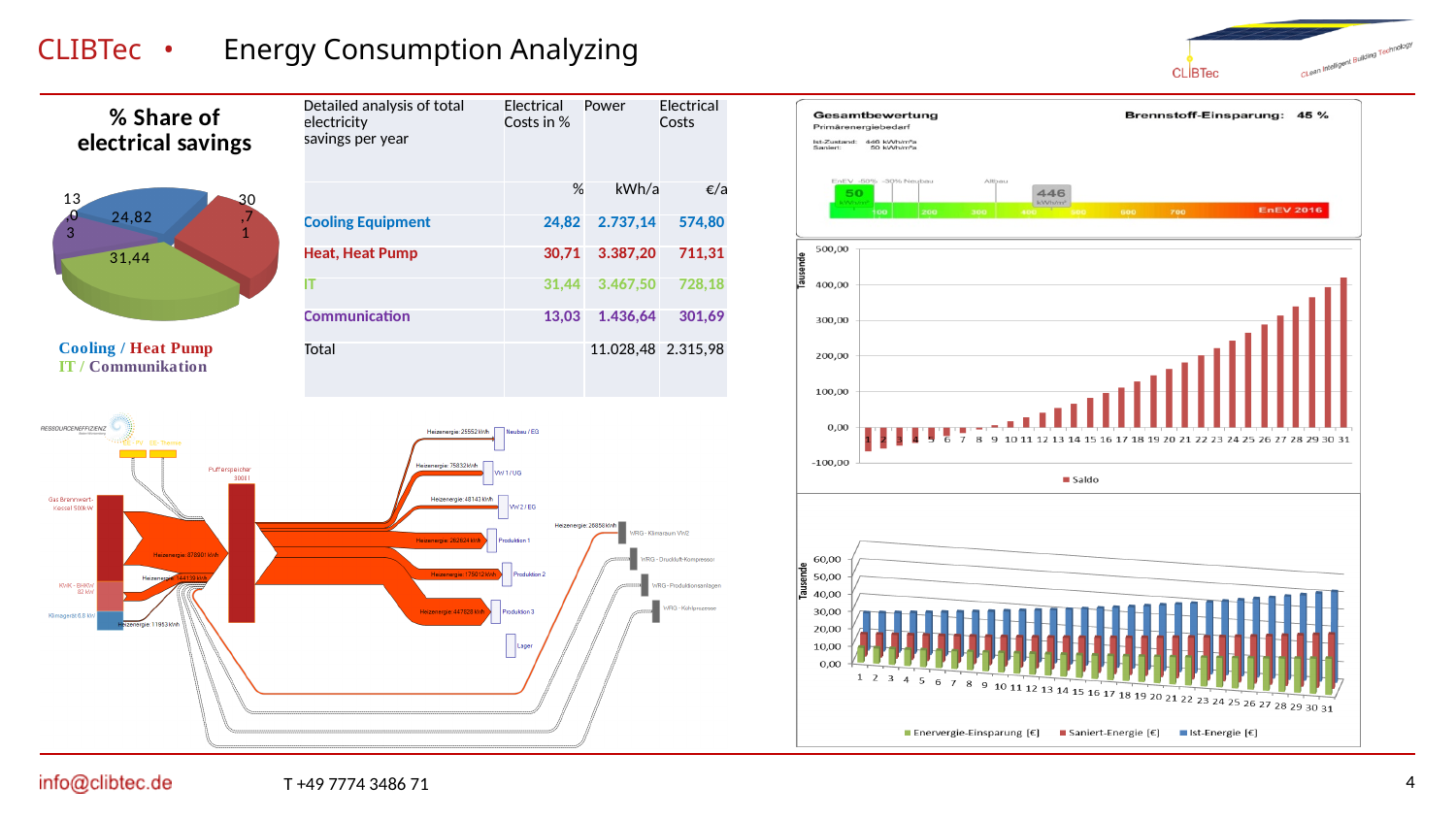
In the '% Share of electrical savings' pie chart, what is the difference between the IT value and the Cooling value? 6,62 In the '% Share of electrical savings' pie chart, which category has the smallest slice? Communikation What are the legend entries of the bottom-right bar chart? Enervergie-Einsparung [€], Saniert-Energie [€], Ist-Energie [€] How many series does the legend of the bottom-right bar chart list? 3 In the 'Saldo' bar chart on the right, is the value for category 31 greater or less than 400,00? greater How many slices does the '% Share of electrical savings' pie chart have? 4 In the 'Saldo' bar chart on the right, how many categories are shown on the x axis? 31 In the '% Share of electrical savings' pie chart, what is the value shown for Cooling? 24,82 In the 'Saldo' bar chart on the right, is the value for category 1 greater or less than 0,00? less What kind of chart is the '% Share of electrical savings' chart? pie chart In the '% Share of electrical savings' pie chart, what is the value shown for IT? 31,44 In the 'Saldo' bar chart on the right, do the values rise or fall from category 1 to category 31? rise